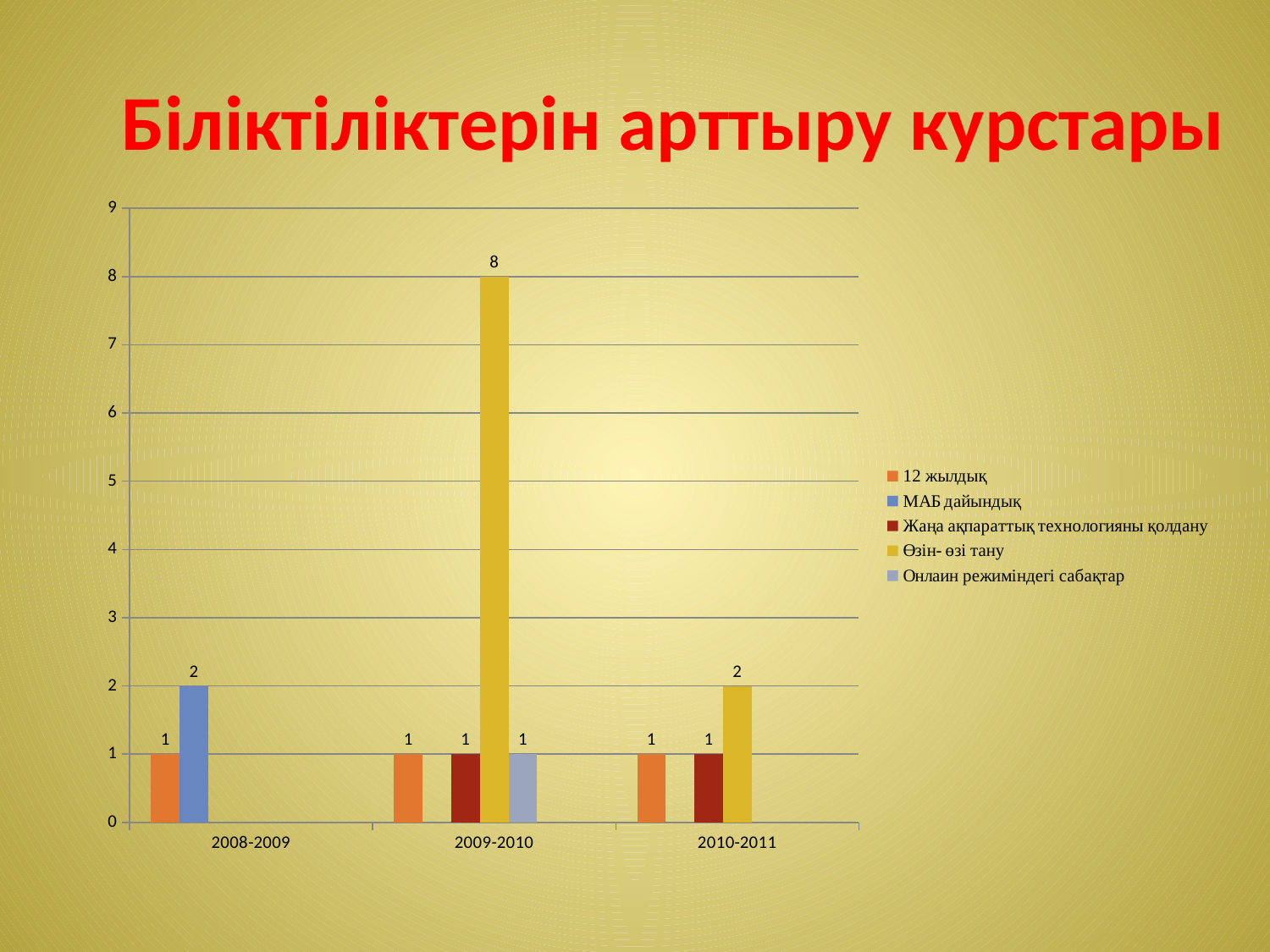
What is the difference between the Өзін- өзі тану values for 2009-2010 and 2010-2011? 6 What is the value for 12 жылдық in 2010-2011? 1 What is the value for Өзін- өзі тану in 2010-2011? 2 What is the value for МАБ дайындық in 2008-2009? 2 What type of chart is shown on the slide? bar chart How many series does the legend list? 5 Which series has the highest value in 2009-2010? Өзін- өзі тану Which is larger: МАБ дайындық in 2008-2009 or 12 жылдық in 2008-2009? МАБ дайындық in 2008-2009 How many categories are shown on the x axis? 3 What is the title of the slide? Біліктіліктерін арттыру курстары How does the value for Өзін- өзі тану change from 2009-2010 to 2010-2011? falls What is the value for Өзін- өзі тану in 2009-2010? 8